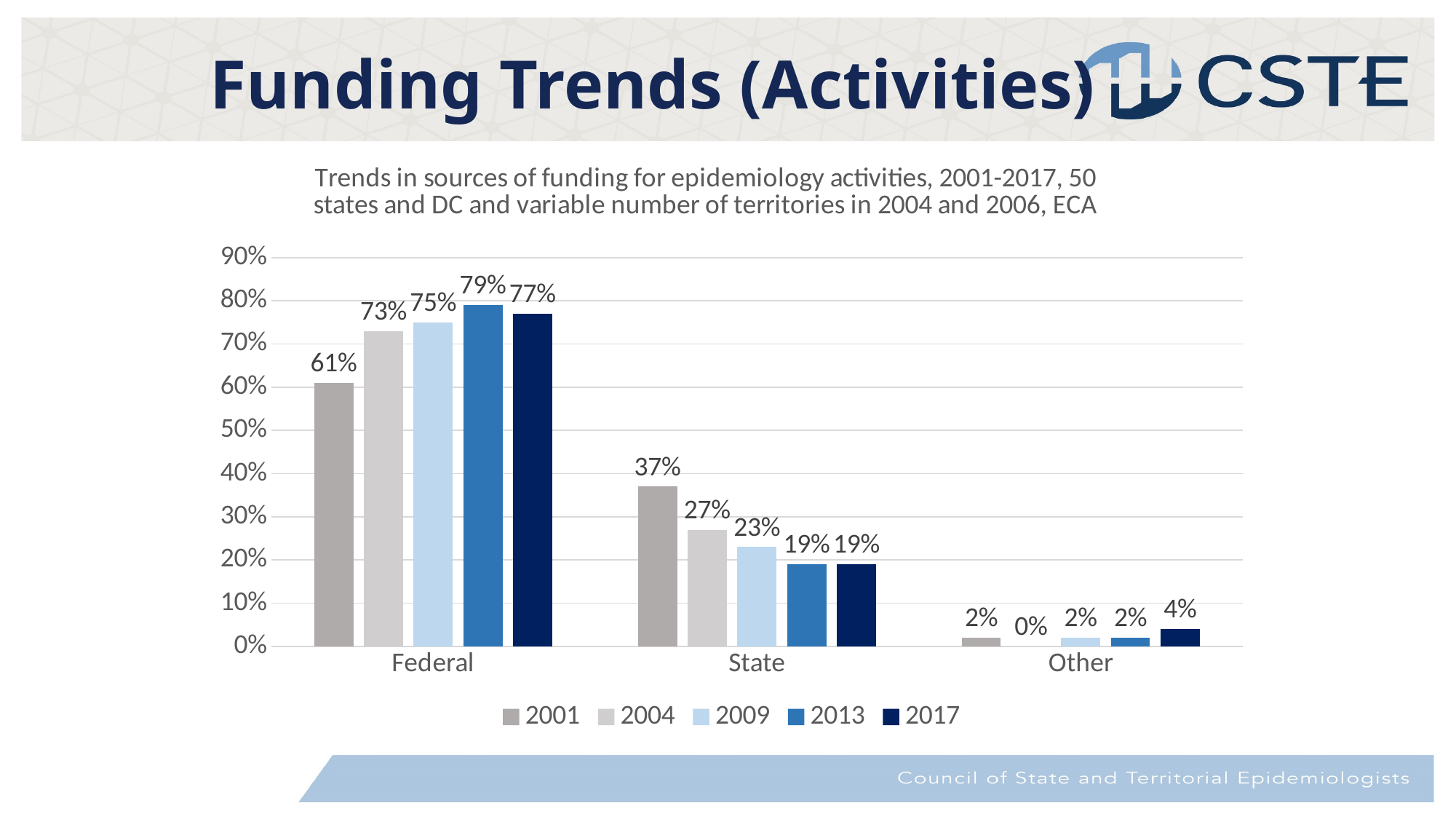
Which is larger: the State share in 2001 or the State share in 2009? State share in 2001 How many funding source categories are shown on the x axis? 3 What was the Other share of funding in 2004? 0% In which year was the Federal share of funding highest? 2013 What was the State share of funding in 2017? 19% What kind of chart is shown on the slide? Bar chart How many years does the legend list? 5 What is the difference between the Federal share in 2013 and the Federal share in 2001? 18% What was the Federal share of funding in 2001? 61% Is the Federal share of funding in 2004 greater or less than 70%? greater Did the State share of funding rise or fall from 2001 to 2017? Fall